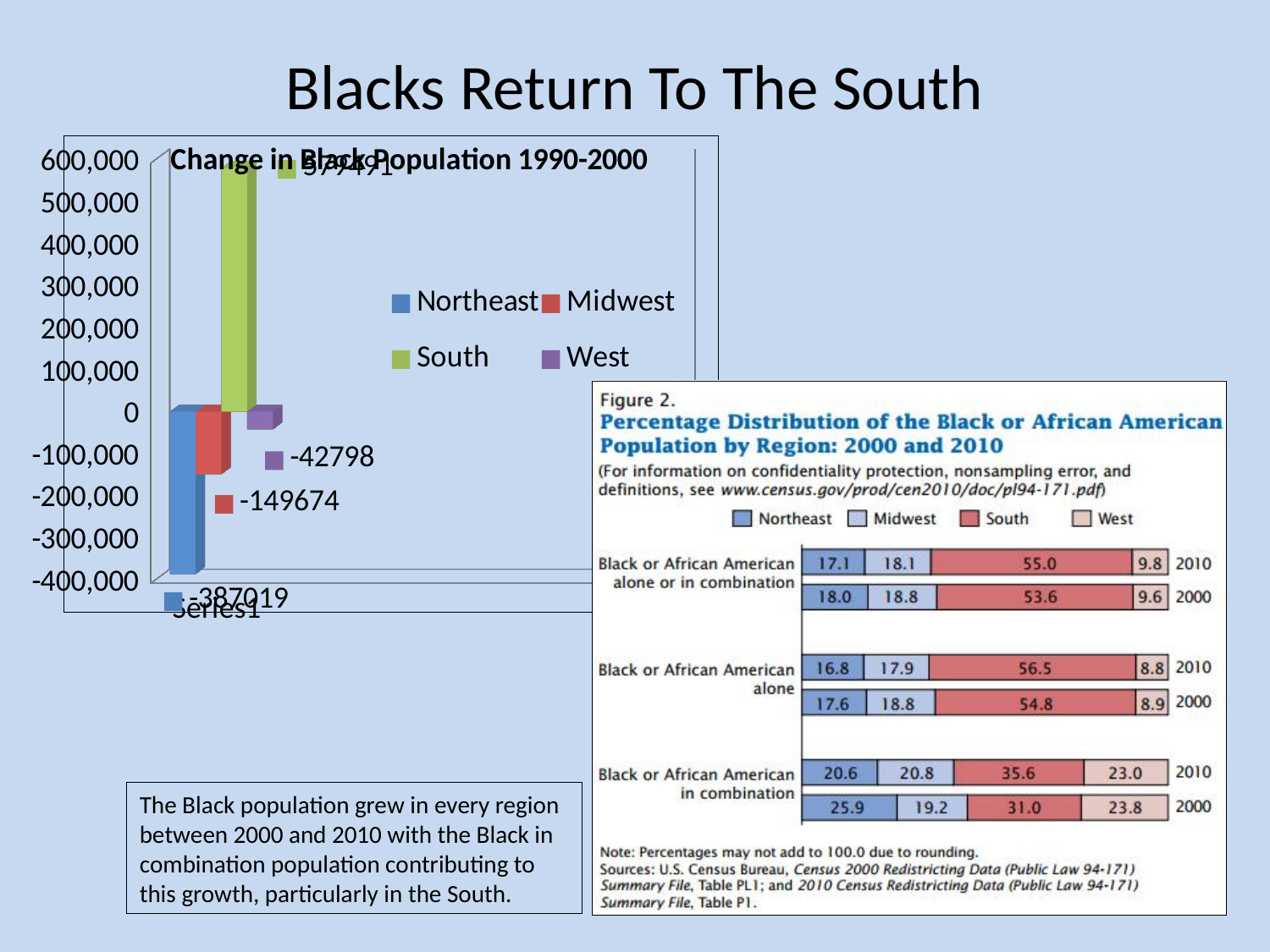
In the Figure 2 chart, what percentage of the Black or African American in combination population lived in the West in 2000? 23.8 In the 'Change in Black Population 1990-2000' chart, which region has the lowest value? Northeast What kind of chart is the 'Change in Black Population 1990-2000' chart? bar chart In the 'Change in Black Population 1990-2000' chart, is the value for South greater or less than 500,000? greater In the 'Change in Black Population 1990-2000' chart, how many series does the legend list? 4 In the 'Change in Black Population 1990-2000' chart, what is the value for Northeast? -387019 In the 'Change in Black Population 1990-2000' chart, which region has the highest value? South In the 'Change in Black Population 1990-2000' chart, what is the value for Midwest? -149674 In the Figure 2 chart, what is the difference between the Northeast share of the Black or African American in combination population in 2000 and in 2010? 5.3 In the Figure 2 chart, for the Black or African American alone population, which is larger: the South share in 2010 or in 2000? 2010 In the Figure 2 chart, what percentage of the Black or African American alone or in combination population lived in the South in 2010? 55.0 In the 'Change in Black Population 1990-2000' chart, what is the value for West? -42798